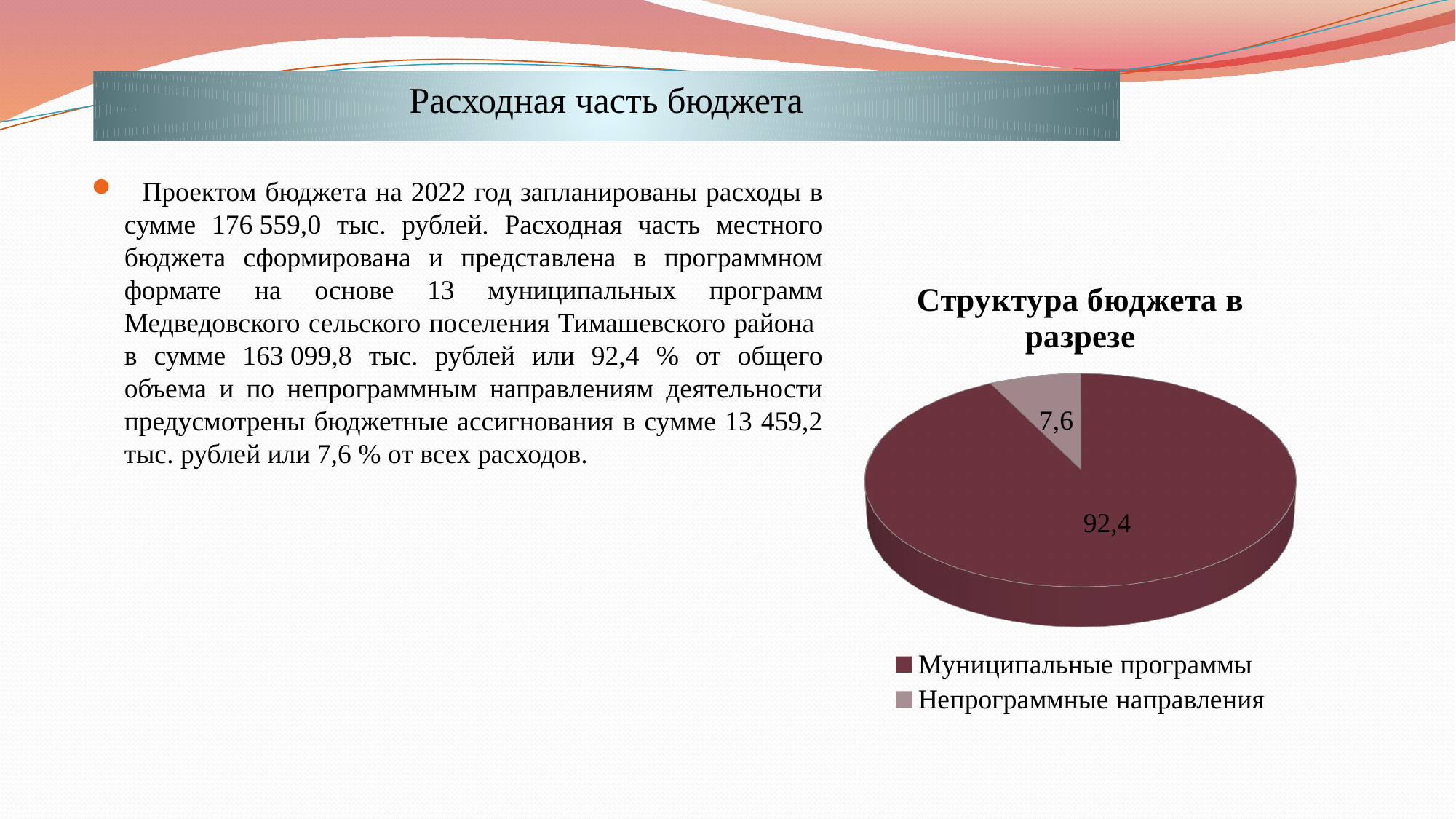
What type of chart is shown on the slide? Pie chart Which is larger: Муниципальные программы or Непрограммные направления? Муниципальные программы How many slices does the pie chart have? 2 How many entries does the legend list? 2 What is the difference between the values for Муниципальные программы and Непрограммные направления? 84,8 Which category has the largest slice in the pie chart? Муниципальные программы Which category has the smallest slice in the pie chart? Непрограммные направления What is the title of the chart? Структура бюджета в разрезе What is the total of the two values shown in the pie chart? 100 What value is shown for Муниципальные программы in the pie chart? 92,4 Which legend entry is shown in the lighter pink colour? Непрограммные направления What value is shown for Непрограммные направления in the pie chart? 7,6